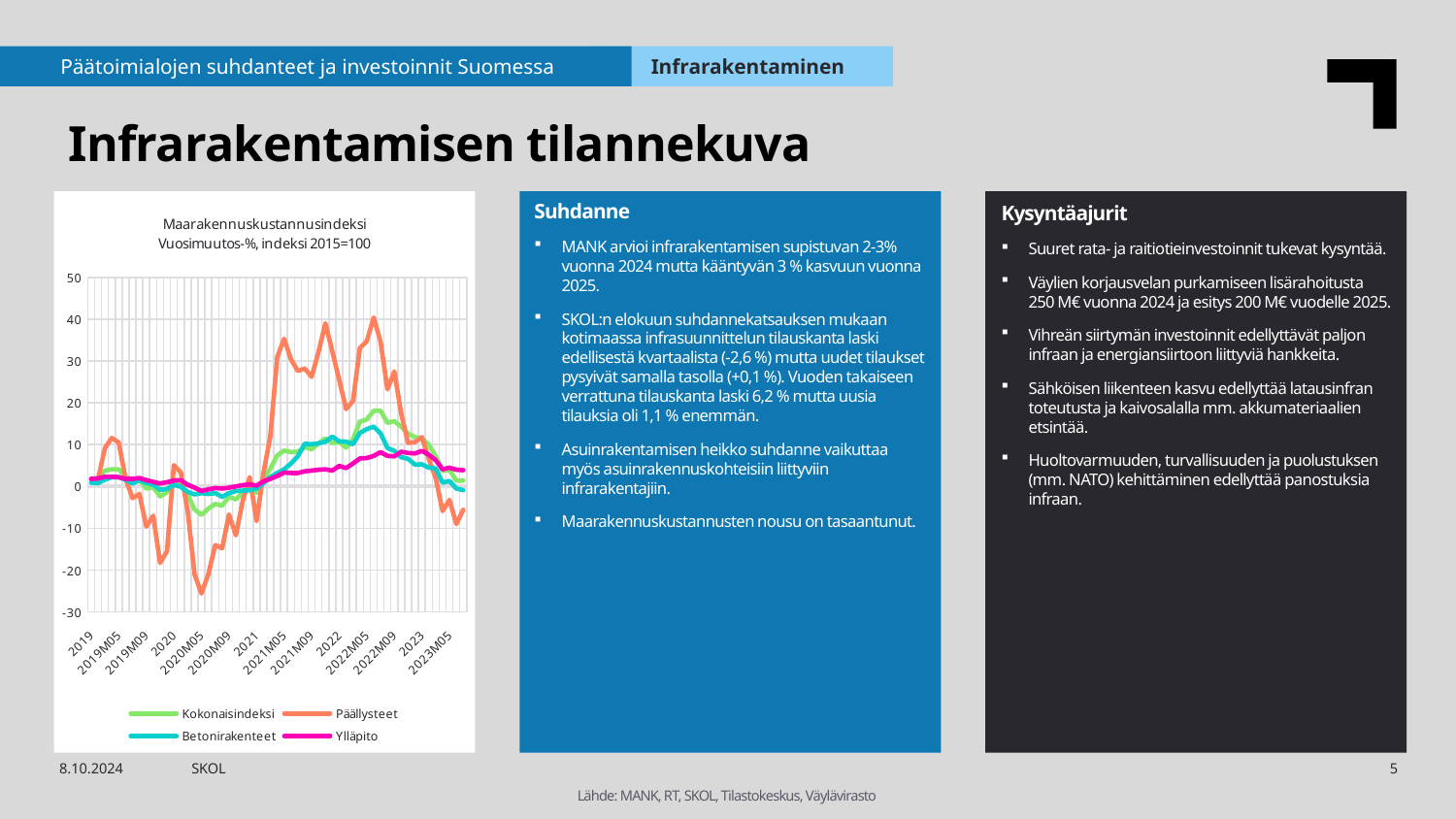
Is the lowest value of Päällysteet around 2020M05 greater or less than -20? less How many series does the chart legend list? 4 Which series reaches the highest value on the chart? Päällysteet Which series reaches the lowest value on the chart? Päällysteet Is the peak value of Päällysteet around 2022M05 greater or less than 30? greater At 2022M05, which series has the larger value, Päällysteet or Ylläpito? Päällysteet How many labels are shown on the x axis of the chart? 14 Is the peak value of Kokonaisindeksi around 2022M05 greater or less than 10? greater What is the title of the chart? Maarakennuskustannusindeksi Vuosimuutos-%, indeksi 2015=100 Does the Päällysteet series rise or fall between 2022M09 and 2023M05? Fall Which series are listed in the chart legend? Kokonaisindeksi, Päällysteet, Betonirakenteet, Ylläpito What kind of chart is shown on the slide? Line chart